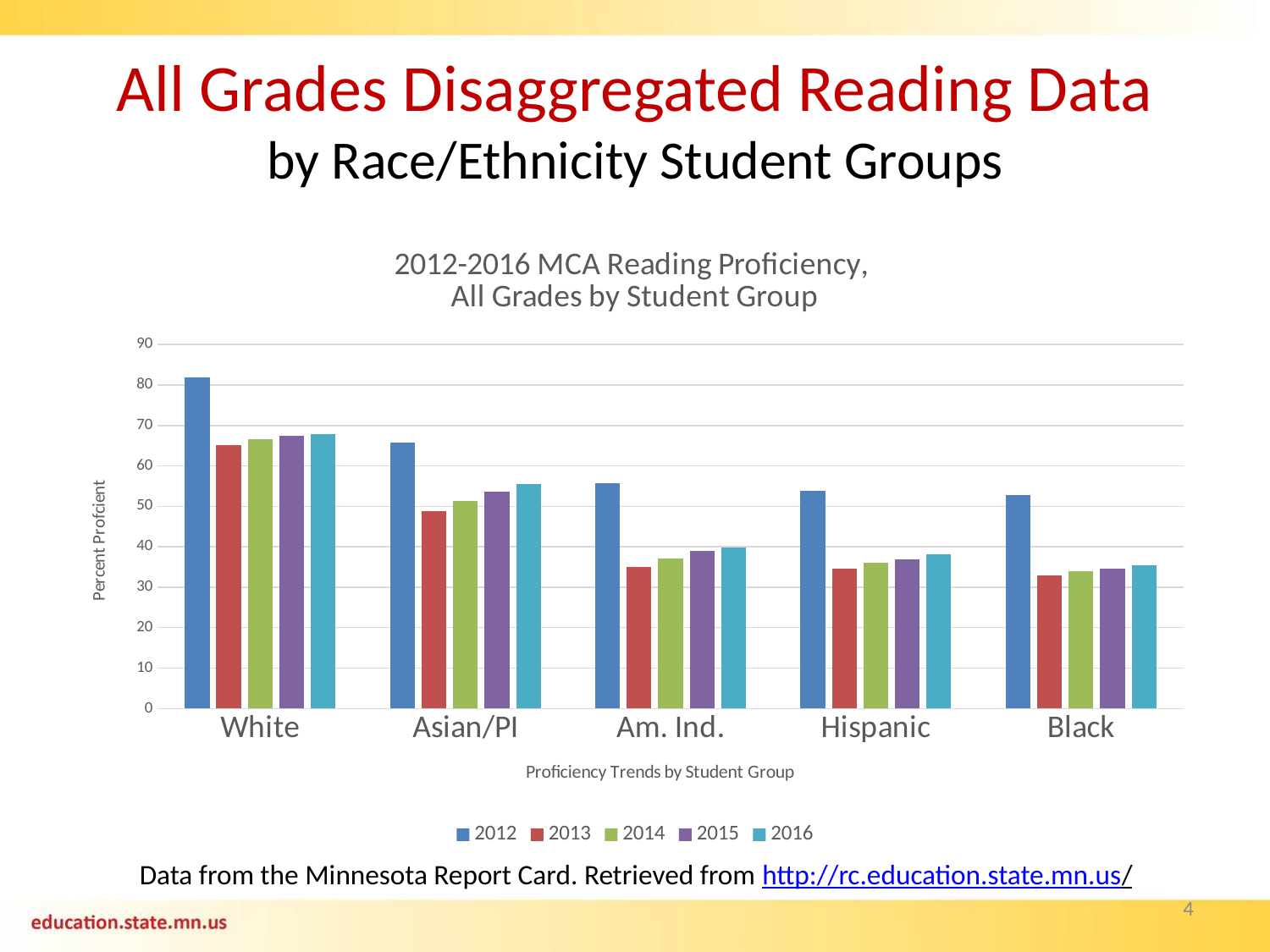
How many series does the chart's legend list? 5 Is the 2016 value for Asian/PI greater or less than 50? greater Which student group has the highest 2012 reading proficiency value? White What kind of chart is shown on the slide? bar chart For the Am. Ind. group, do the values rise or fall from 2013 to 2016? rise Is the 2013 value for Black greater or less than 30? greater Which is larger, the 2016 value for White or the 2016 value for Asian/PI? White Which student group has the lowest 2013 reading proficiency value? Black Is the 2012 value for Hispanic greater or less than 50? greater What is the label on the chart's vertical axis? Percent Profcient How many student groups are shown on the x axis of the chart? 5